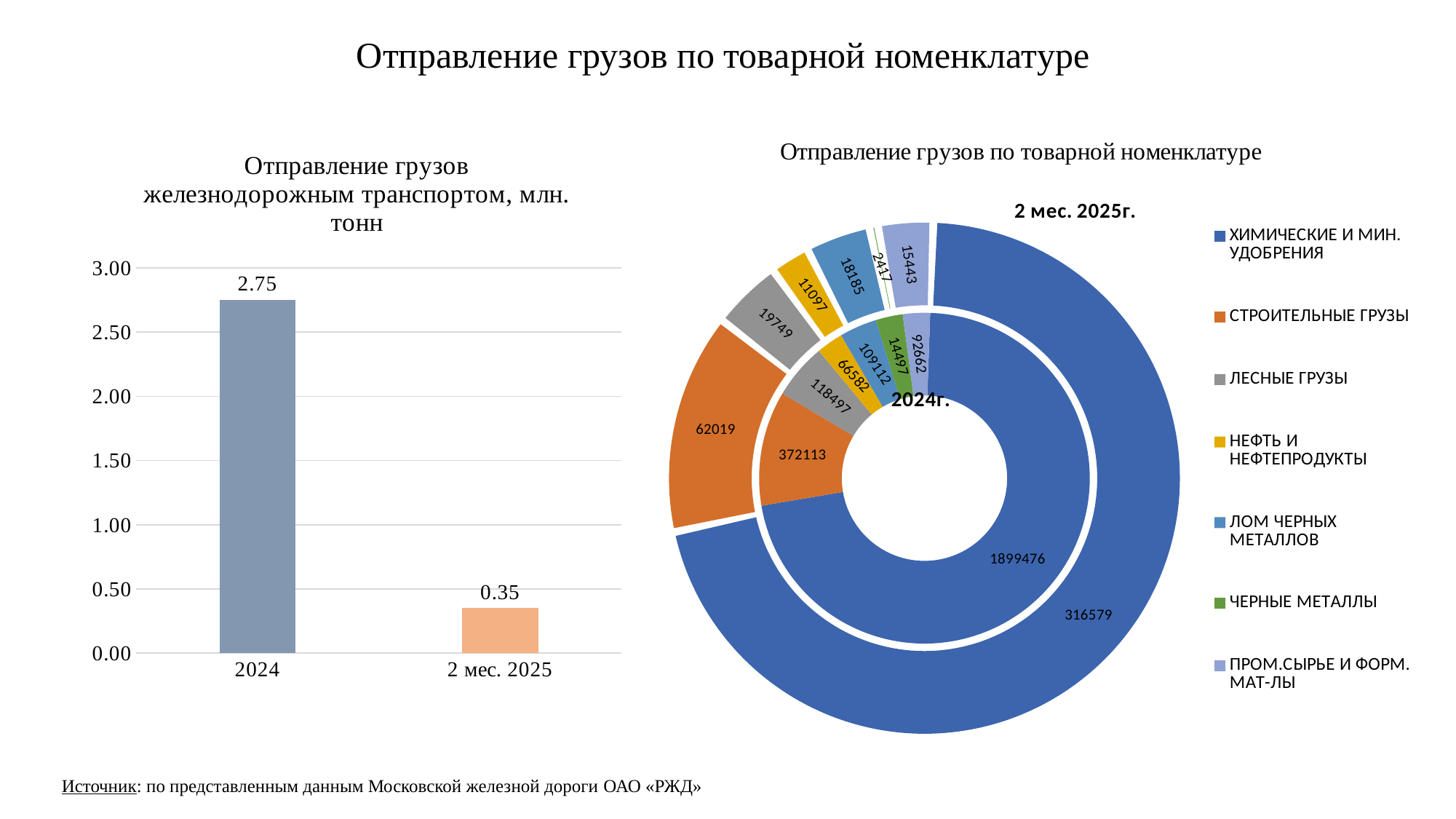
In the bar chart on the left, what is the value for 2 мес. 2025? 0.35 In the doughnut chart on the right, what is the value for ХИМИЧЕСКИЕ И МИН. УДОБРЕНИЯ in the 2024г. ring? 1899476 In the bar chart on the left, what is the difference between the 2024 value and the 2 мес. 2025 value? 2.40 In the doughnut chart on the right, which is larger in the 2024г. ring: ЛЕСНЫЕ ГРУЗЫ or ЛОМ ЧЕРНЫХ МЕТАЛЛОВ? ЛЕСНЫЕ ГРУЗЫ In the doughnut chart on the right, which category has the smallest value in the 2 мес. 2025г. ring? ЧЕРНЫЕ МЕТАЛЛЫ In the bar chart on the left, what is the value for 2024? 2.75 How many categories does the legend of the doughnut chart on the right list? 7 In the doughnut chart on the right, which category has the largest value in the 2024г. ring? ХИМИЧЕСКИЕ И МИН. УДОБРЕНИЯ In the doughnut chart on the right, what is the value for СТРОИТЕЛЬНЫЕ ГРУЗЫ in the 2 мес. 2025г. ring? 62019 What kind of chart is the chart on the left? bar chart In the doughnut chart on the right, what is the value for ЧЕРНЫЕ МЕТАЛЛЫ in the 2 мес. 2025г. ring? 2417 How many bars are in the bar chart on the left? 2